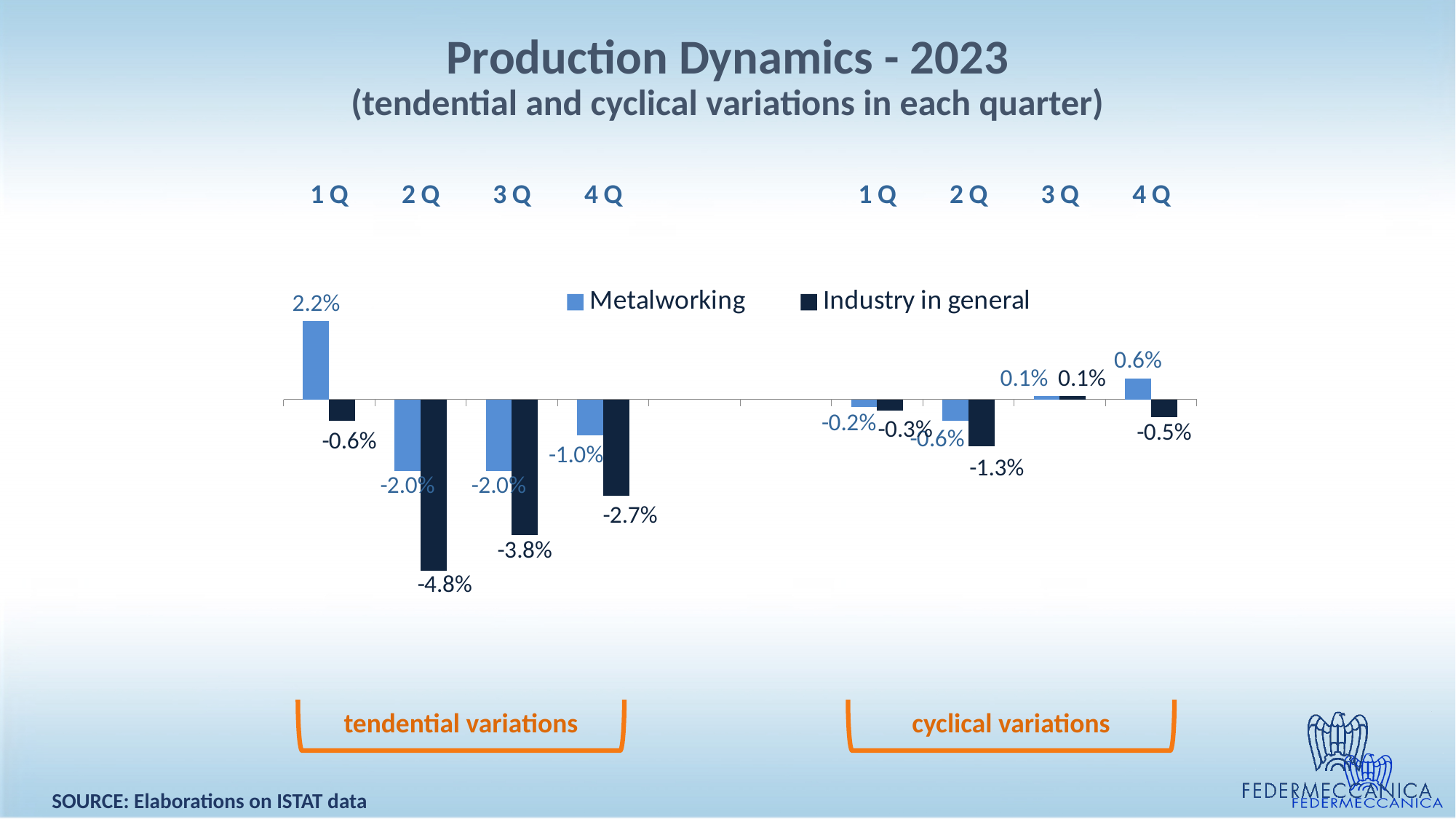
What is the tendential variation for Industry in general in 2 Q? -4.8% Among the tendential variations, in which quarter is the Metalworking value highest? 1 Q What is the cyclical variation for Metalworking in 4 Q? 0.6% How many series does the legend list? 2 How many quarters are shown in the cyclical variations group? 4 Among the tendential variations, in which quarter is the Industry in general value lowest? 2 Q What is the difference between the Metalworking and Industry in general tendential variations in 3 Q? 1.8 percentage points What type of chart is shown on the slide? Bar chart Which colour represents Metalworking in the chart? Light blue In the tendential variations for 4 Q, which series has the larger value, Metalworking or Industry in general? Metalworking What is the cyclical variation for Industry in general in 2 Q? -1.3% What is the tendential variation for Metalworking in 1 Q? 2.2%